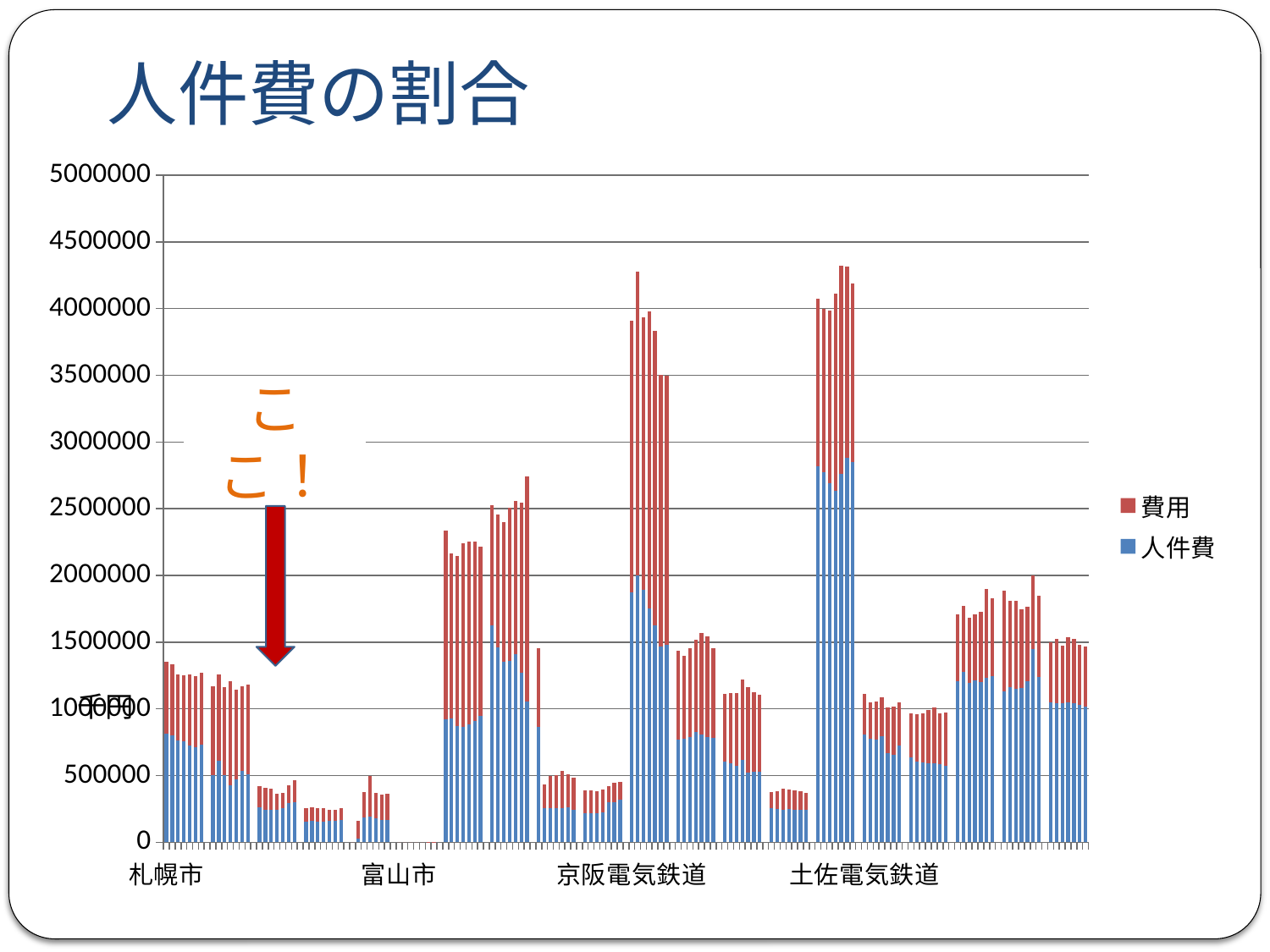
What is the title of the chart? 人件費の割合 Which labelled group has taller bars directly above its label: 札幌市 or 京阪電気鉄道? 京阪電気鉄道 Are the tallest stacked bars above the 京阪電気鉄道 label greater or less than 3500000? greater Are the stacked bars directly above the 札幌市 label greater or less than 1500000? less Which labelled group has shorter bars directly above its label: 富山市 or 土佐電気鉄道? 富山市 Are the stacked bars directly above the 札幌市 label greater or less than 1000000? greater What is the highest value shown on the y axis? 5000000 Which series is shown in blue in the legend? 人件費 What kind of chart is shown on the slide? Stacked bar chart How many series does the legend list? 2